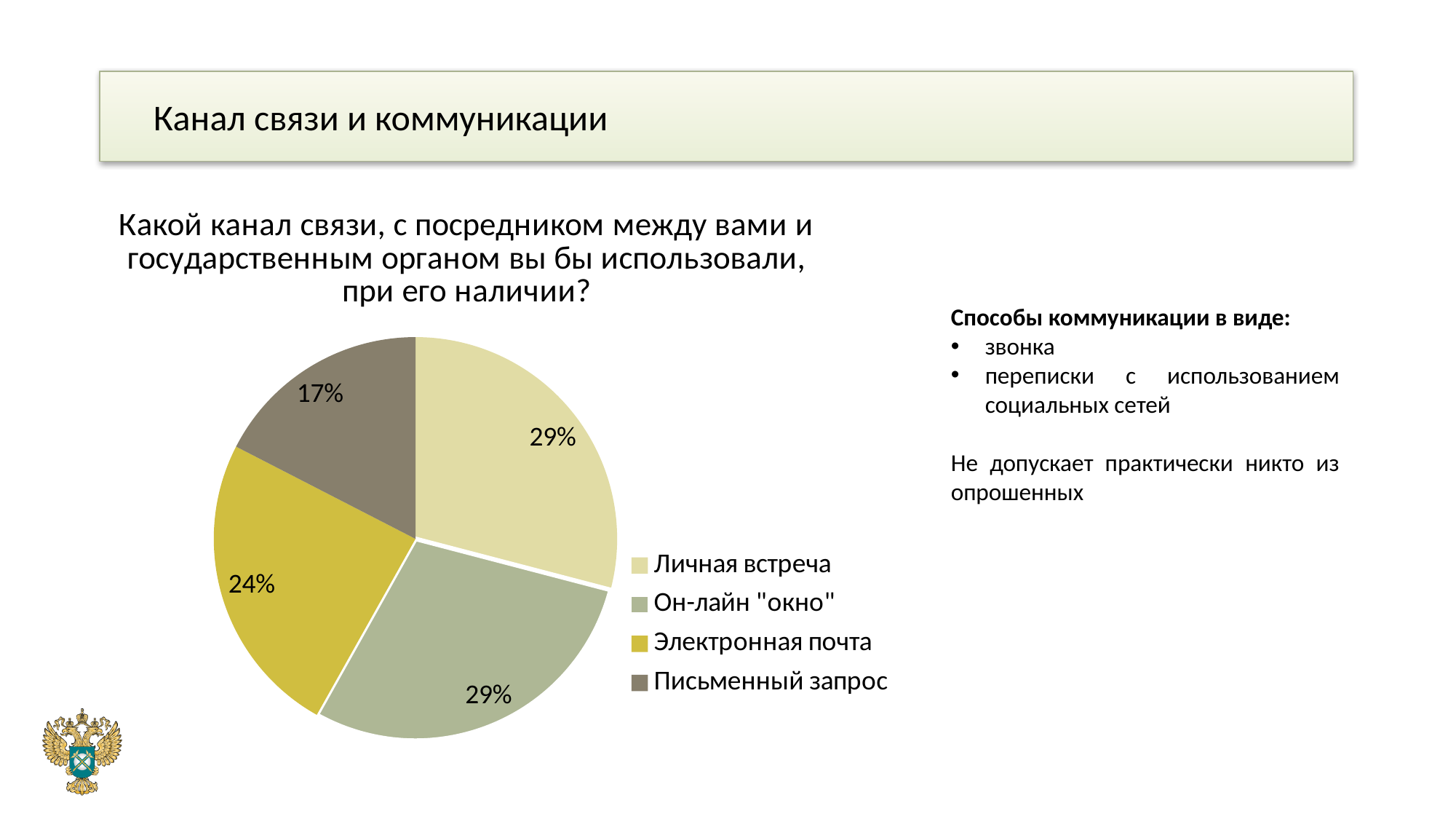
Which two categories share the same value of 29%? Личная встреча and Он-лайн "окно" Which legend entry is shown with the darkest (brown-grey) colour? Письменный запрос What kind of chart is shown on the slide? Pie chart Which category has the smallest slice of the pie? Письменный запрос What is the value shown for Он-лайн "окно"? 29% Which is larger, the slice for Электронная почта or the slice for Письменный запрос? Электронная почта What is the difference in percentage points between Личная встреча and Электронная почта? 5 What is the difference in percentage points between Электронная почта and Письменный запрос? 7 What is the value shown for Электронная почта? 24% How many categories are shown in the pie chart? 4 What share of the pie does Личная встреча have? 29% What is the value shown for Письменный запрос? 17%